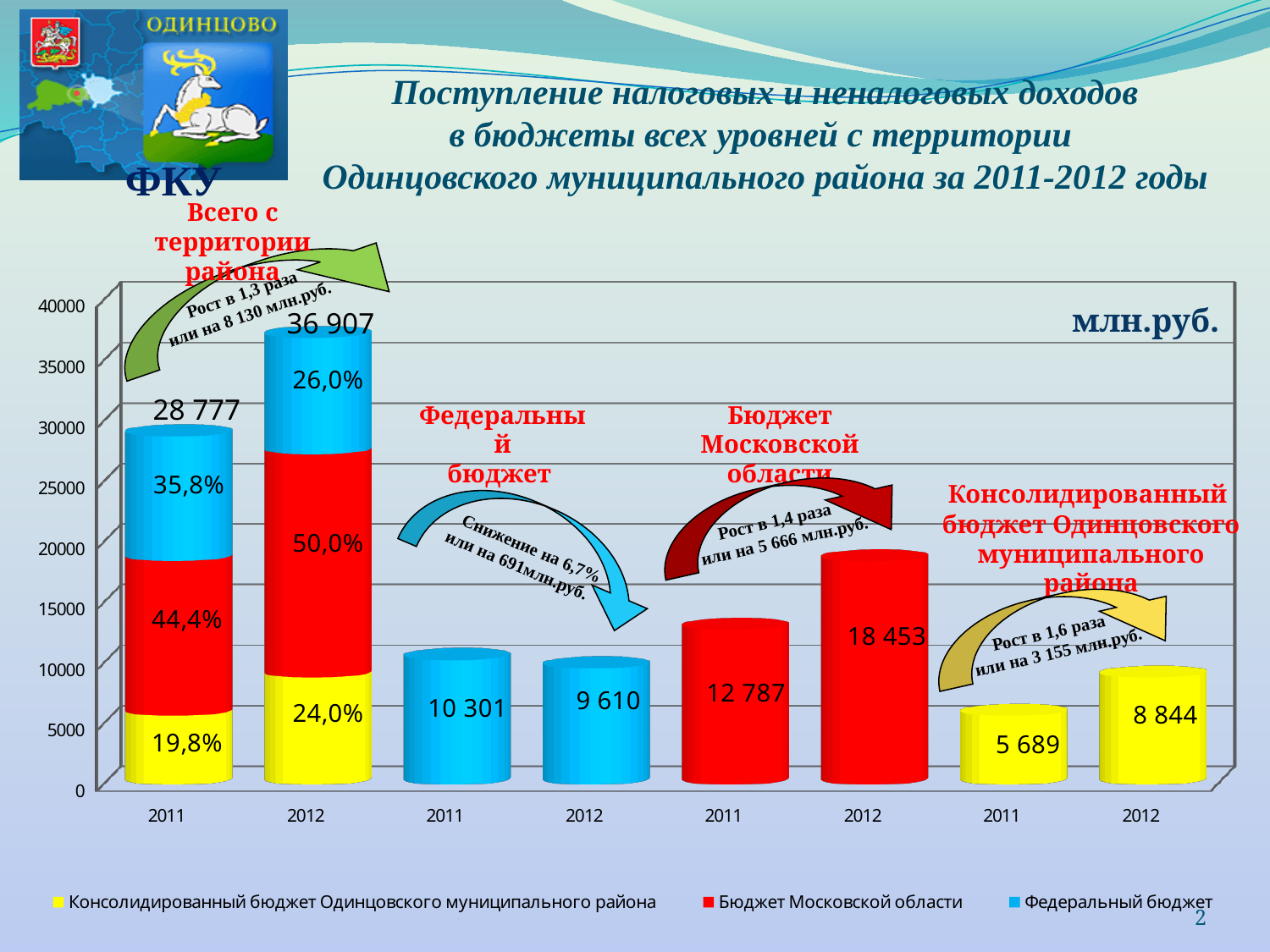
By how much did the Бюджет Московской области value change from 2011 to 2012? 5 666 What is the total value shown for 'Всего с территории района' in 2011? 28 777 What is the total value shown for 'Всего с территории района' in 2012? 36 907 What kind of chart is shown on the slide? bar chart What value is shown for the Бюджет Московской области bar in 2012? 18 453 What value is shown for the Федеральный бюджет bar in 2011? 10 301 Which is larger: the Федеральный бюджет value in 2011 or in 2012? 2011 Did the Консолидированный бюджет Одинцовского муниципального района value rise or fall from 2011 to 2012? rise What unit of measurement is indicated on the chart? млн.руб. What value is shown for the Консолидированный бюджет Одинцовского муниципального района bar in 2011? 5 689 How many series does the legend list? 3 What percentage share does the Бюджет Московской области segment have in the 2012 stacked bar for 'Всего с территории района'? 50,0%